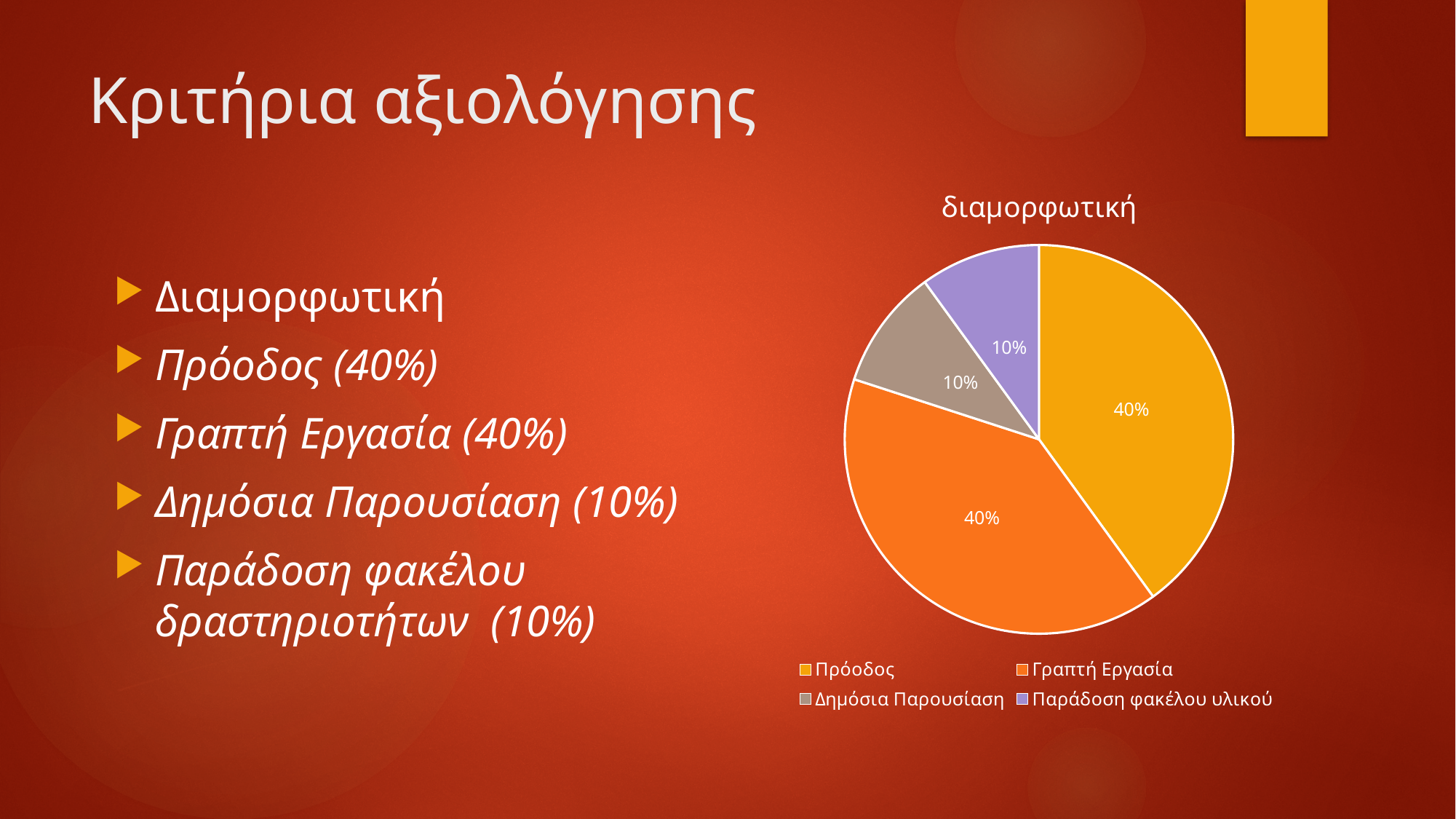
What is the difference between the shares of Γραπτή Εργασία and Παράδοση φακέλου υλικού? 30% What share of the pie does Παράδοση φακέλου υλικού have? 10% What kind of chart is shown on the slide? pie chart What share of the pie does Πρόοδος have? 40% What share of the pie does Δημόσια Παρουσίαση have? 10% How many slices does the pie chart have? 4 What colour is the Πρόοδος slice in the pie chart? yellow What is the title of the pie chart? διαμορφωτική How many entries does the legend of the pie chart list? 4 Which is larger in the pie chart, Πρόοδος or Δημόσια Παρουσίαση? Πρόοδος Which is larger in the pie chart, Παράδοση φακέλου υλικού or Γραπτή Εργασία? Γραπτή Εργασία